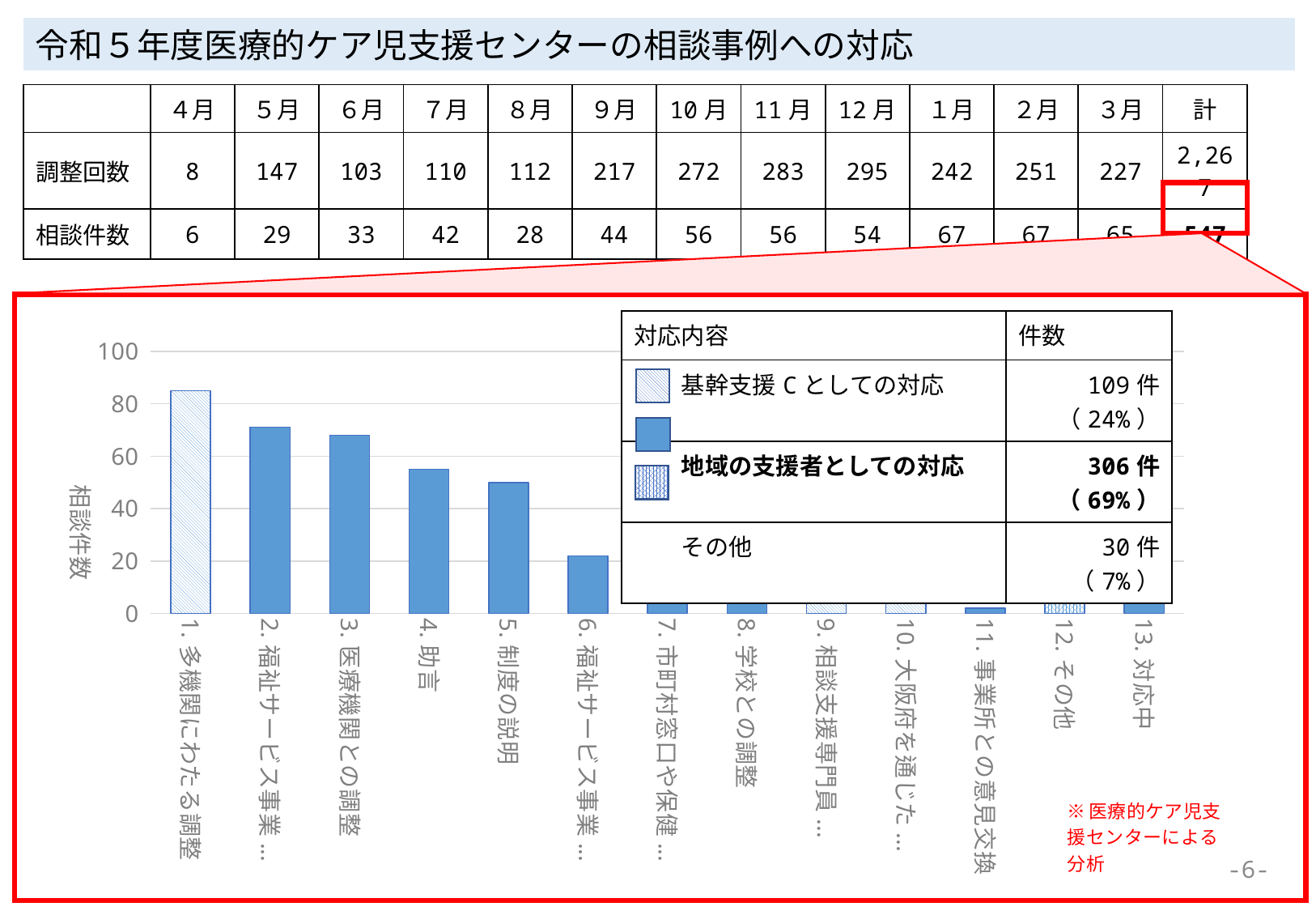
How many categories are plotted along the x axis of the bar chart? 13 Is the value for 6. 福祉サービス事業… greater or less than 40? less What kind of chart is shown on the slide? bar chart Do the bar values generally rise or fall from left to right along the x axis? fall Is the value for 1. 多機関にわたる調整 greater or less than 80? greater What is the label on the y axis of the bar chart? 相談件数 Is the value for 5. 制度の説明 greater or less than 60? less Which category has the highest value in the bar chart? 1. 多機関にわたる調整 Which is larger, the value for 5. 制度の説明 or the value for 6. 福祉サービス事業…? 5. 制度の説明 Which is larger, the value for 1. 多機関にわたる調整 or the value for 2. 福祉サービス事業…? 1. 多機関にわたる調整